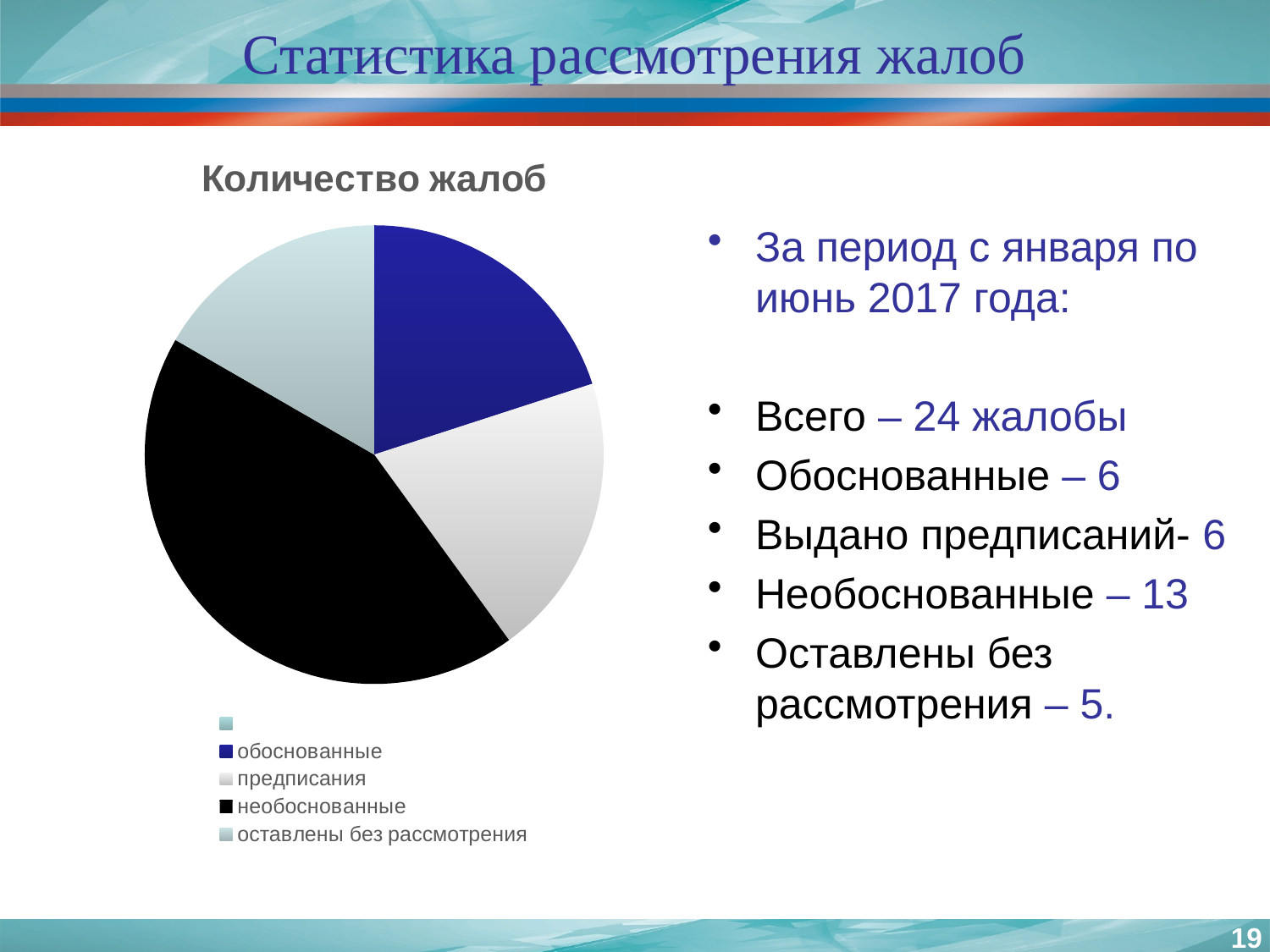
How many labelled entries does the legend list? 4 Does the slice for необоснованные take up more or less than half of the pie? less What colour is the slice for необоснованные? black Which slice is larger: необоснованные or обоснованные? необоснованные What is the title of the chart? Количество жалоб Which category has the largest slice of the pie? необоснованные How many slices does the pie chart have? 4 What kind of chart is shown on the slide? pie chart Which slice is larger: необоснованные or предписания? необоснованные